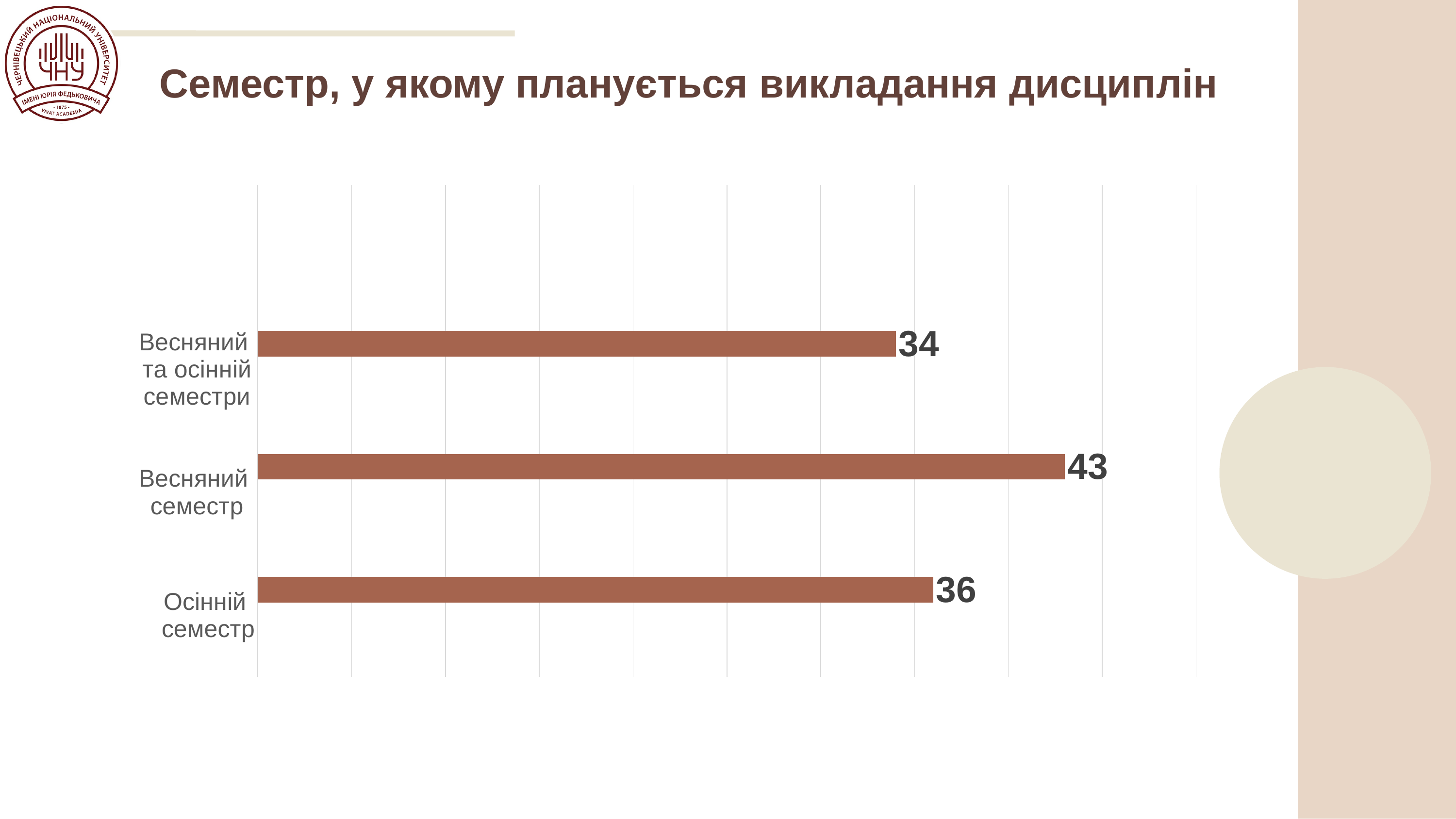
What is the title of the slide? Семестр, у якому планується викладання дисциплін Which is larger: the value for Весняний семестр or the value for Весняний та осінній семестри? Весняний семестр Which category has the lowest value? Весняний та осінній семестри What kind of chart is shown on the slide? Bar chart What is the total of the three values shown in the chart? 113 What is the value for Весняний семестр? 43 What is the value for Весняний та осінній семестри? 34 How many categories are shown in the chart? 3 What is the difference between the values for Весняний семестр and Осінній семестр? 7 Which category has the highest value? Весняний семестр What is the value for Осінній семестр? 36 What is the difference between the values for Осінній семестр and Весняний та осінній семестри? 2